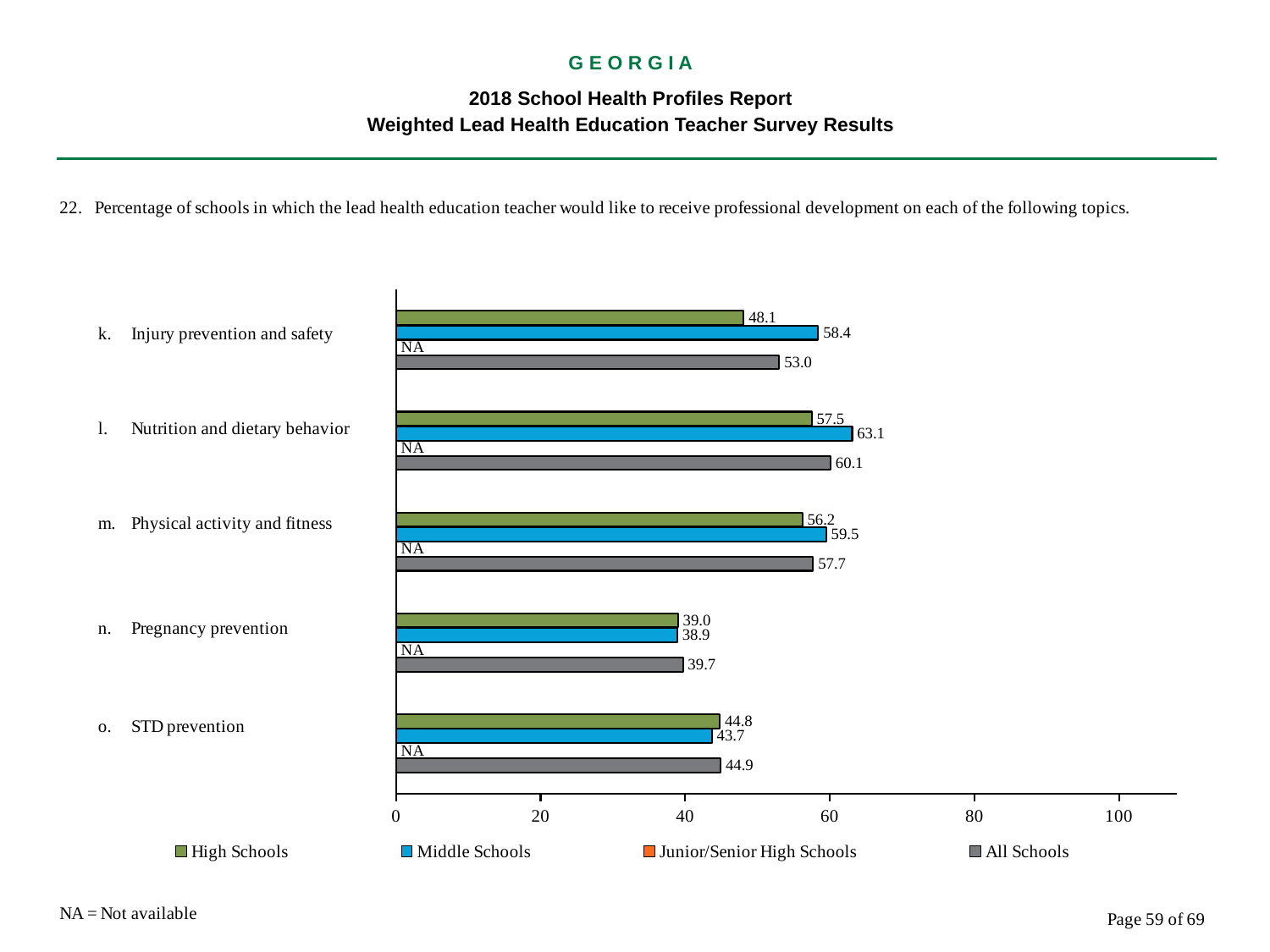
Which is larger for Physical activity and fitness: the High Schools value or the Middle Schools value? Middle Schools How many topics are shown on the chart? 5 Is the All Schools value for Nutrition and dietary behavior greater or less than 60? greater Which topic has the highest All Schools value? Nutrition and dietary behavior What is the value for Middle Schools for STD prevention? 43.7 What is the All Schools value for Pregnancy prevention? 39.7 What kind of chart is shown? Bar chart What is the difference between the Middle Schools and High Schools values for Injury prevention and safety? 10.3 Which topic has the lowest Middle Schools value? Pregnancy prevention What is the value for High Schools for Injury prevention and safety? 48.1 What is the value for Middle Schools for Nutrition and dietary behavior? 63.1 How many series does the legend list? 4